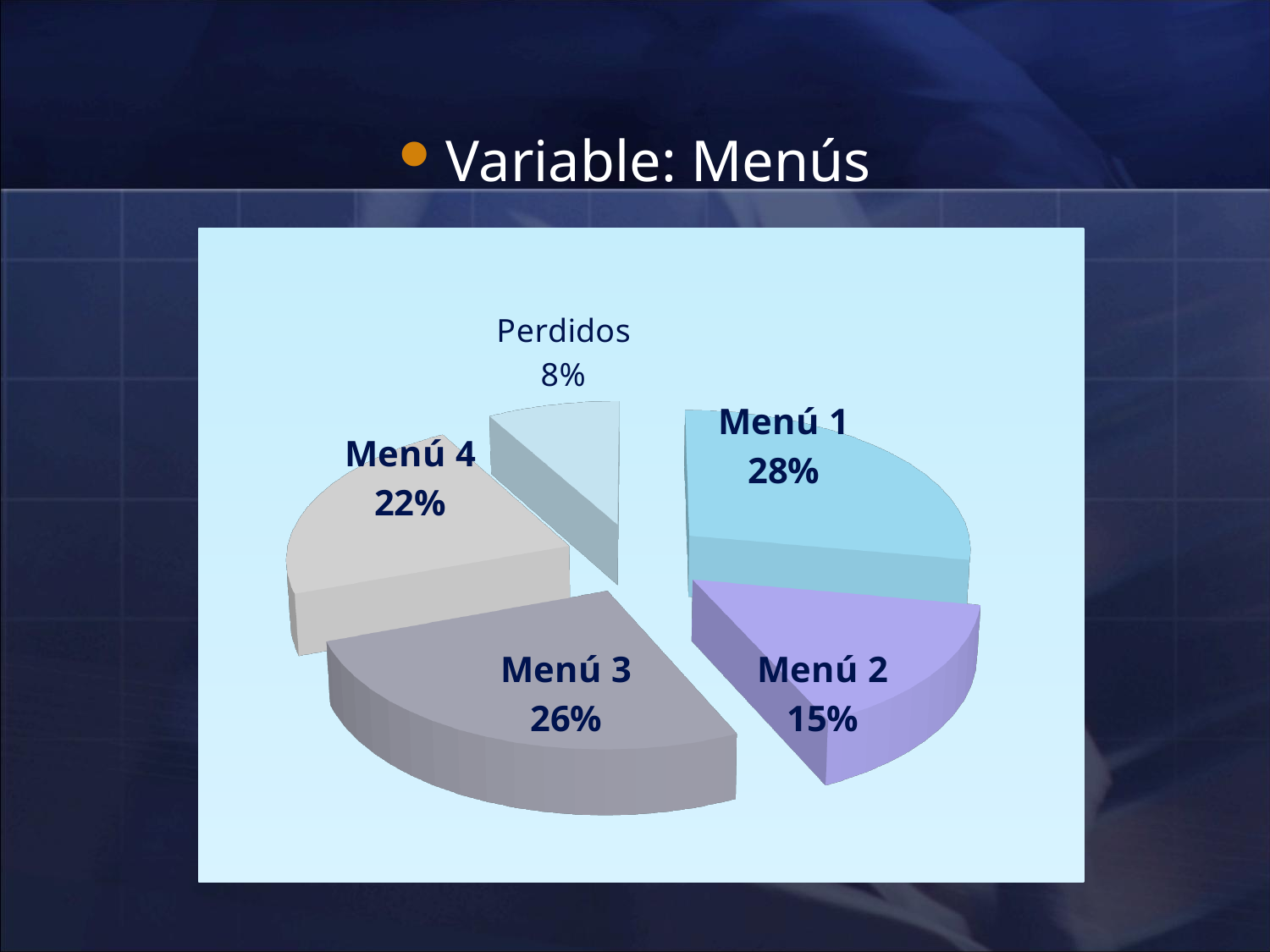
Which slice has the largest share of the pie? Menú 1 Which slice has the smallest share of the pie? Perdidos What percentage does the Perdidos slice represent? 8% What percentage does the Menú 4 slice represent? 22% What percentage does the Menú 2 slice represent? 15% What percentage does the Menú 3 slice represent? 26% How many slices does the pie chart have? 5 What is the difference in percentage points between Menú 1 and Menú 2? 13 What percentage does the Menú 1 slice represent? 28% What is the title shown above the chart on the slide? Variable: Menús What type of chart is shown on the slide? Pie chart Which is larger, the share for Menú 3 or the share for Menú 4? Menú 3